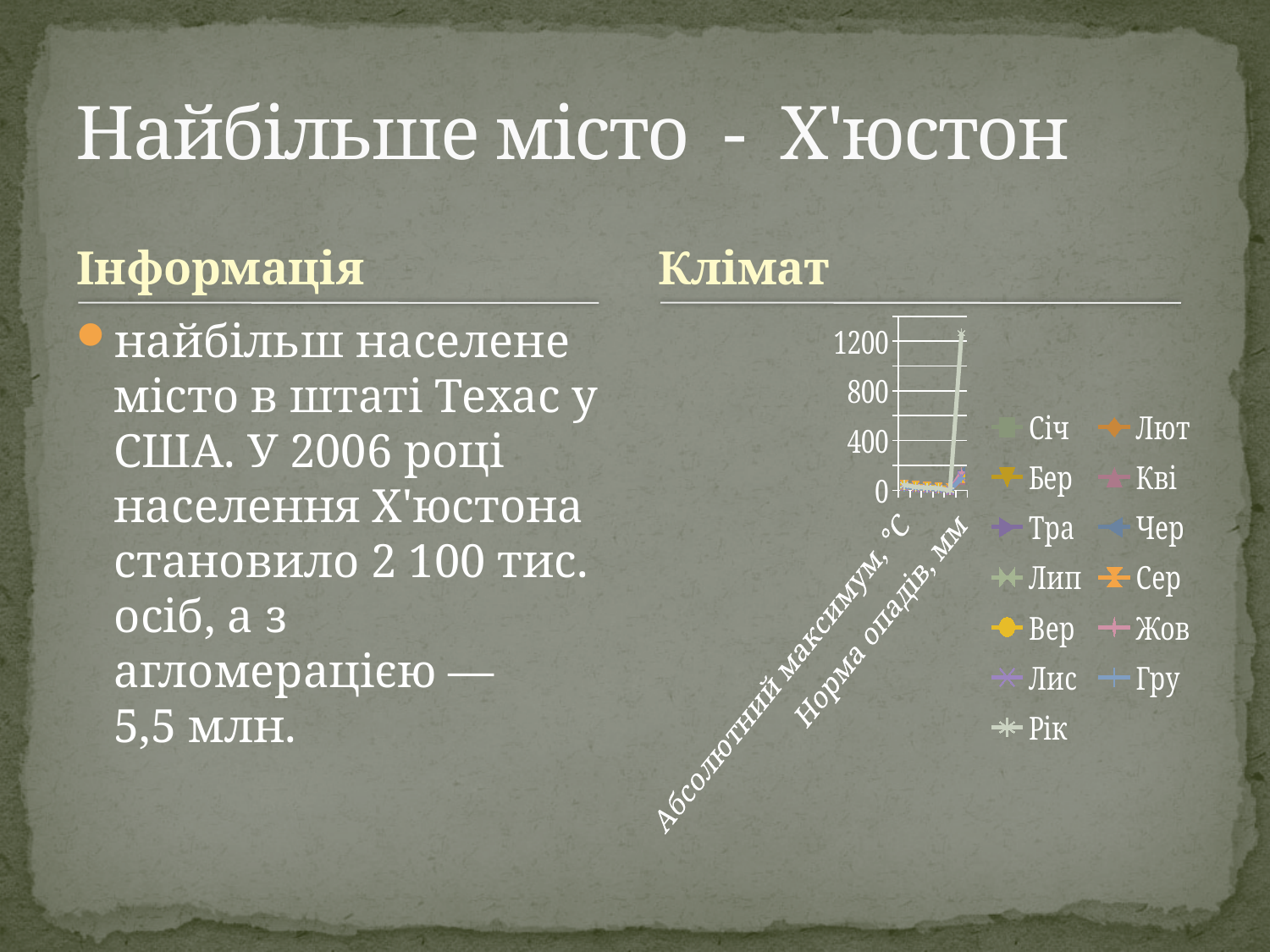
What is the highest value shown on the vertical axis of the climate chart? 1200 Is the value of the "Рік" series for "Норма опадів, мм" greater or less than 800? greater Does the "Рік" series rise or fall from "Абсолютний максимум, °C" to "Норма опадів, мм"? rise Is the value of the "Рік" series for "Абсолютний максимум, °C" greater or less than 400? less How many series does the legend of the climate chart list? 13 Which series is listed first in the legend of the climate chart? Січ What kind of chart is shown under the heading "Клімат"? line chart Which is larger for "Норма опадів, мм": the "Рік" series or the "Лип" series? Рік Is the value of the "Січ" series for "Норма опадів, мм" greater or less than 400? less Which series reaches the highest value on the climate chart? Рік